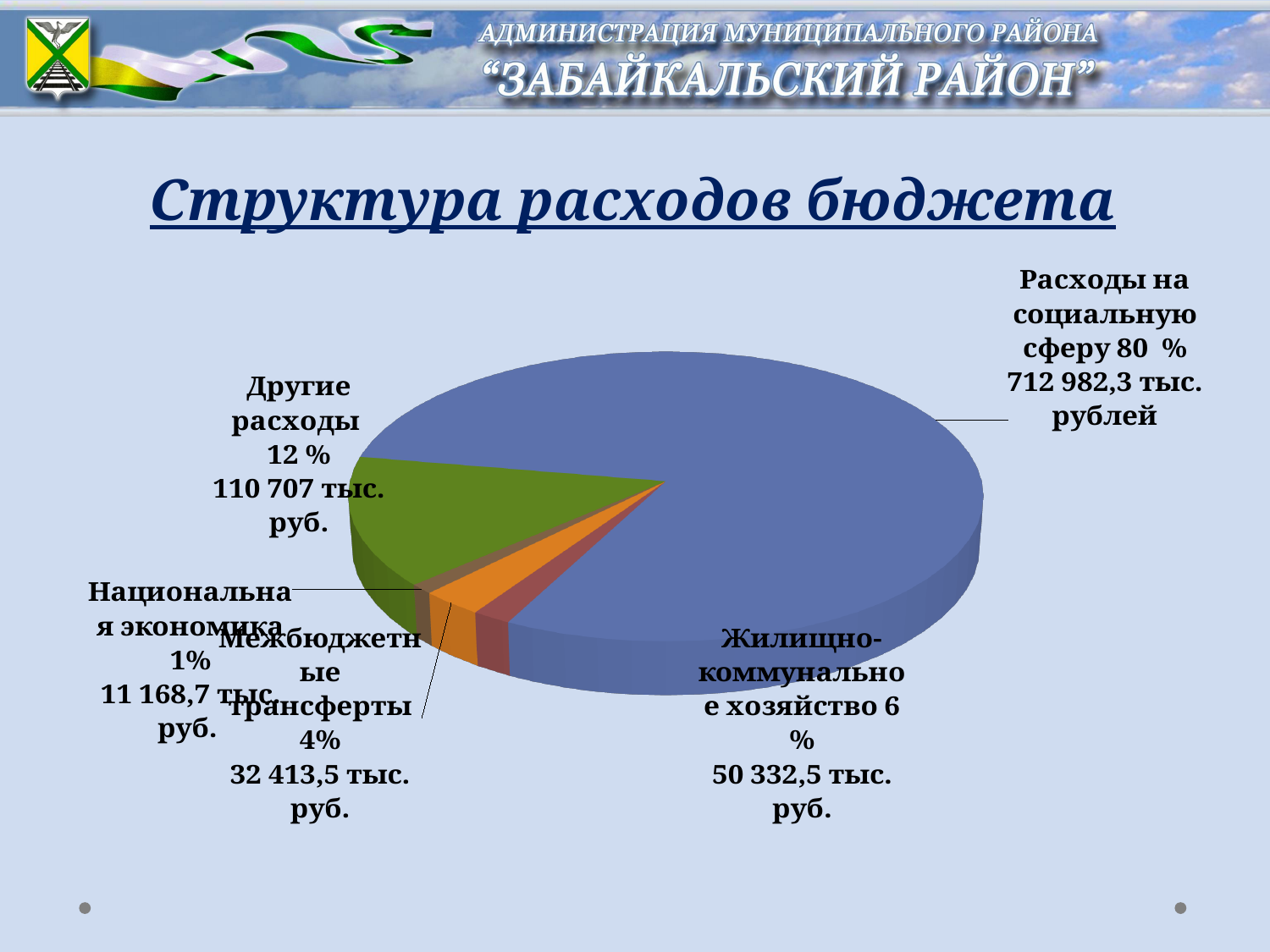
What share of the pie is Межбюджетные трансферты? 4% Which category has the largest share of the budget expenditure? Расходы на социальную сферу Which is larger: the share for Жилищно-коммунальное хозяйство or for Межбюджетные трансферты? Жилищно-коммунальное хозяйство What kind of chart is shown on the slide? Pie chart What is the amount shown for Другие расходы? 110 707 тыс. руб. What is the title of the chart? Структура расходов бюджета What is the amount shown for Национальная экономика? 11 168,7 тыс. руб. By how many percentage points does the share of Расходы на социальную сферу exceed the share of Другие расходы? 68 How many slices does the pie chart have? 5 What is the amount shown for Жилищно-коммунальное хозяйство? 50 332,5 тыс. руб. Which category has the smallest share of the budget expenditure? Национальная экономика What share of the budget expenditure goes to Расходы на социальную сферу? 80 %